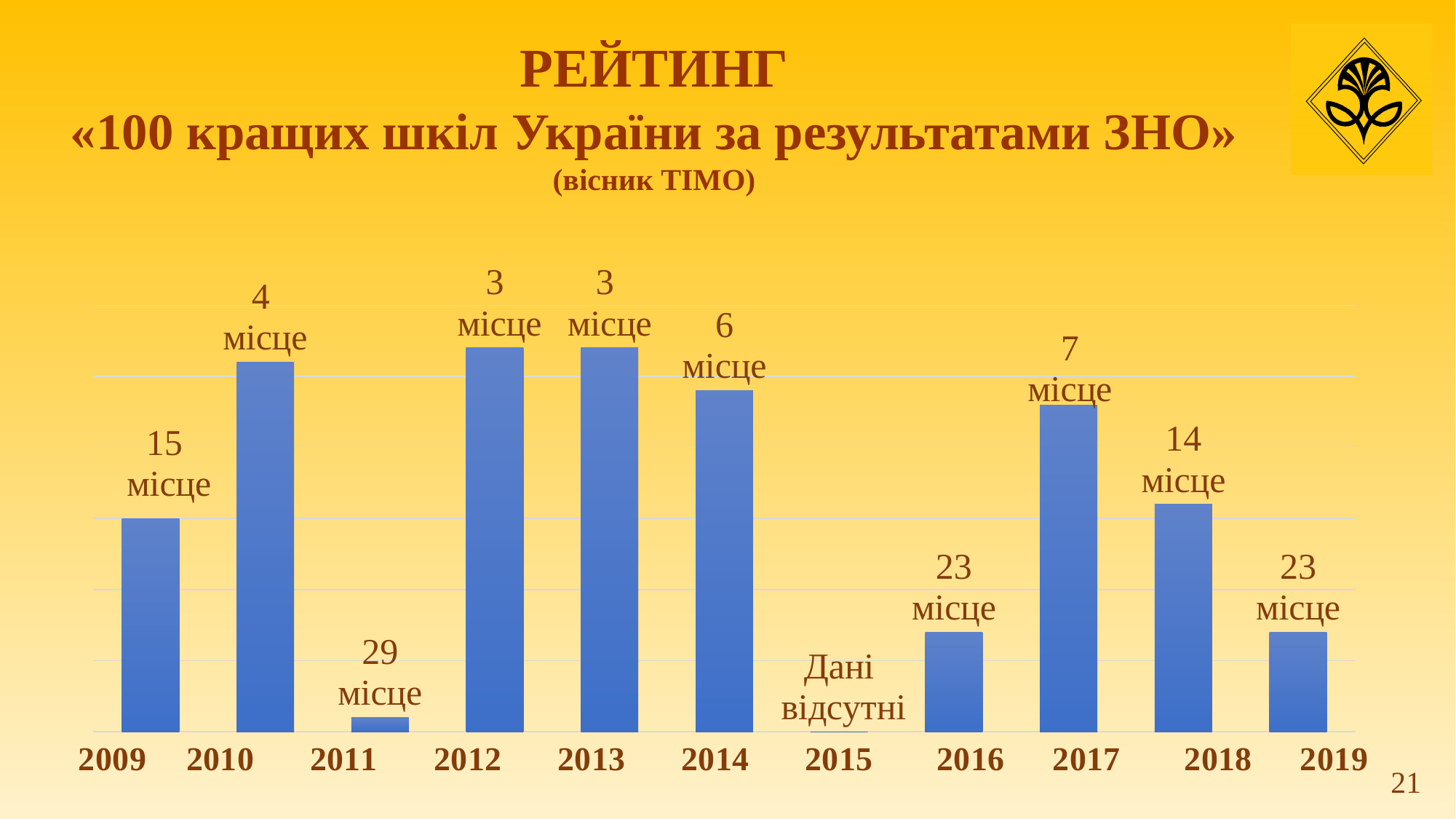
By how many positions does the 2011 ranking differ from the 2012 ranking? 26 Which year has the better ranking position, 2010 or 2018? 2010 What kind of chart is shown on the slide? bar chart Which years share the best (lowest-numbered) ranking position on the chart? 2012 and 2013 What source is named in parentheses under the chart title? вісник ТІМО How many years are shown on the x axis of the chart? 11 What ranking position is shown for 2009? 15 місце Which year has the worst (highest-numbered) ranking position on the chart? 2011 Which two years both show the ranking position 23 місце? 2016 and 2019 What ranking position is shown for 2017? 7 місце What ranking position is shown for 2014? 6 місце What is shown for the year 2015 on the chart? Дані відсутні